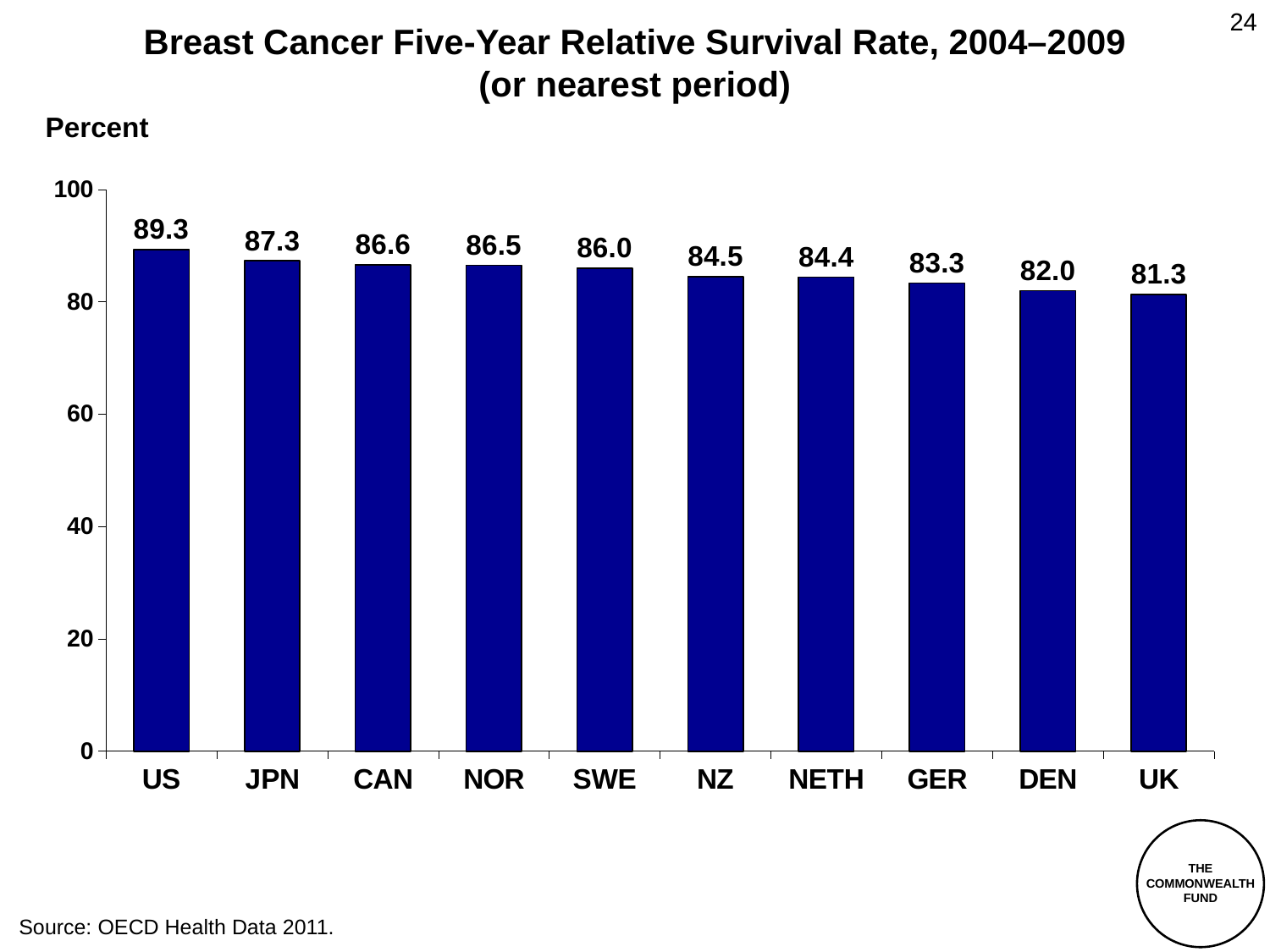
What is the value shown for DEN? 82.0 What is the difference between the values for the US and the UK? 8.0 Which country has the lowest five-year relative survival rate? UK What kind of chart is shown on the slide? Bar chart What is the breast cancer five-year relative survival rate for the US? 89.3 Do the values rise or fall moving from left to right across the chart? Fall What is the difference between the values for JPN and GER? 4.0 How many countries are shown in the chart? 10 Is the value for UK greater or less than 80? greater Which country has the highest five-year relative survival rate? US What is the value shown for NETH? 84.4 Which has a higher survival rate, CAN or SWE? CAN